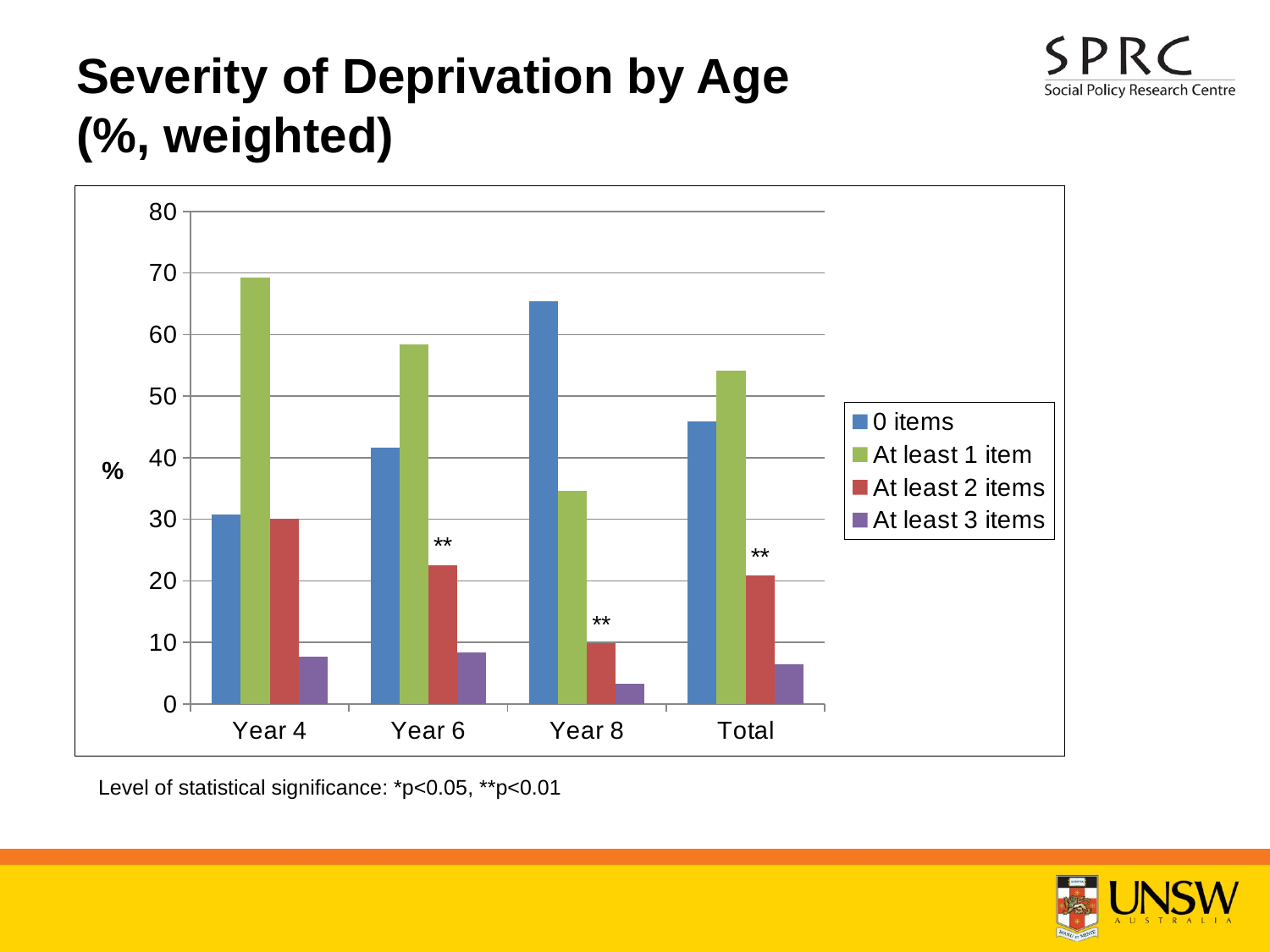
How many series does the legend list? 4 Is the value for 'At least 1 item' in Year 4 greater or less than 60? greater Does the value for 'At least 1 item' rise or fall from Year 4 to Year 8? fall Which category has the highest value for 'At least 1 item'? Year 4 In Year 4, which is larger: '0 items' or 'At least 1 item'? At least 1 item Which category has the highest value for '0 items'? Year 8 Which category has the lowest value for 'At least 3 items'? Year 8 What kind of chart is shown on the slide? bar chart Is the value for 'At least 2 items' in Year 6 greater or less than 30? less What is the label on the y axis? % Is the value for '0 items' in Year 8 greater or less than 60? greater How many categories are shown on the x axis? 4